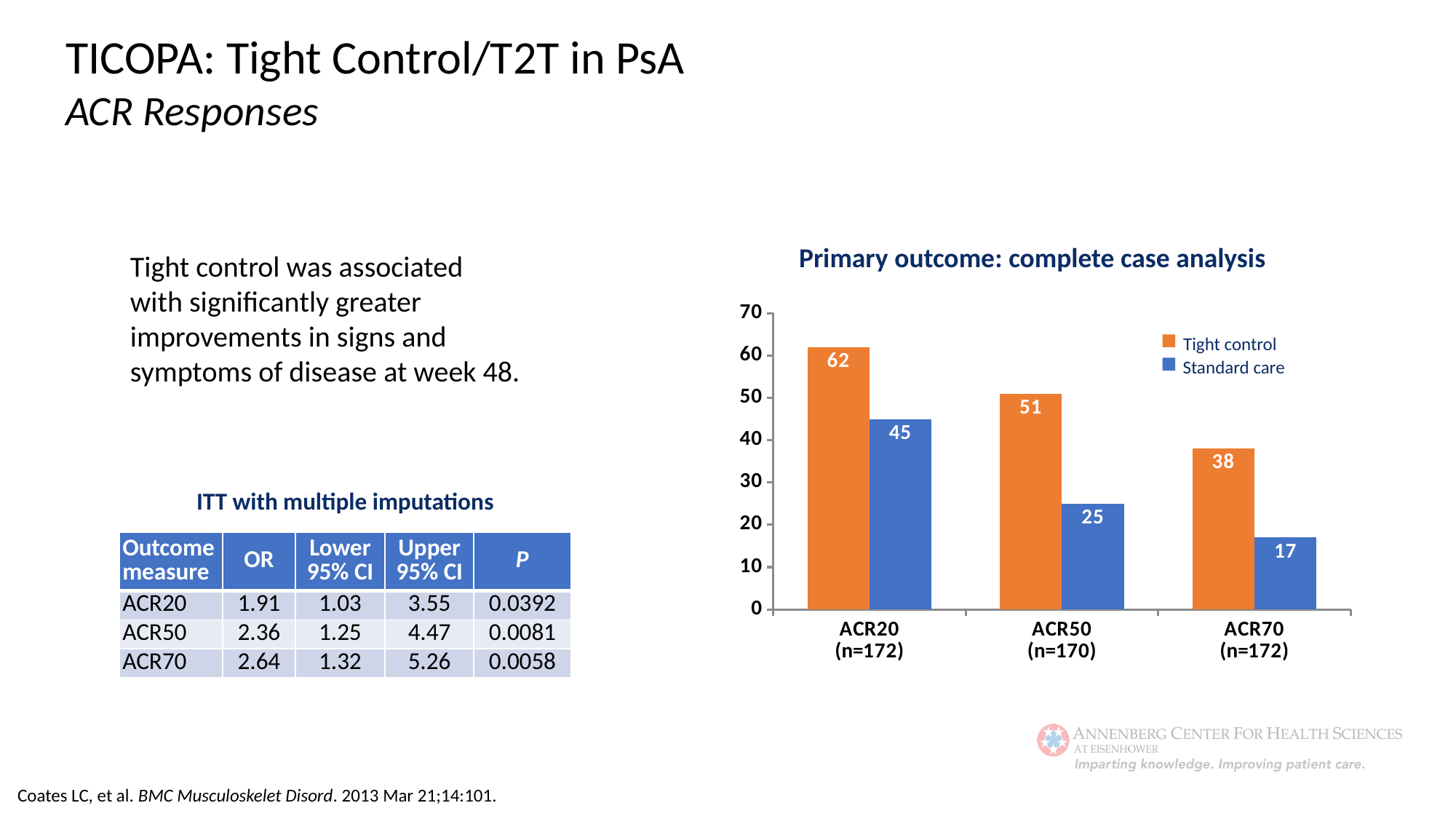
What is the title of the chart? Primary outcome: complete case analysis Which is larger at ACR70 (n=172): Tight control or Standard care? Tight control How many categories are shown on the x axis of the chart? 3 Which category has the lowest Standard care value? ACR70 (n=172) Which category has the highest Tight control value? ACR20 (n=172) What is the difference between Tight control and Standard care at ACR50 (n=170)? 26 What is the value for Standard care at ACR70 (n=172)? 17 How many series does the chart legend list? 2 What is the value for Tight control at ACR20 (n=172)? 62 What kind of chart is shown on the slide? Bar chart Is the value for Standard care at ACR20 (n=172) greater or less than 40? greater What is the value for Standard care at ACR50 (n=170)? 25